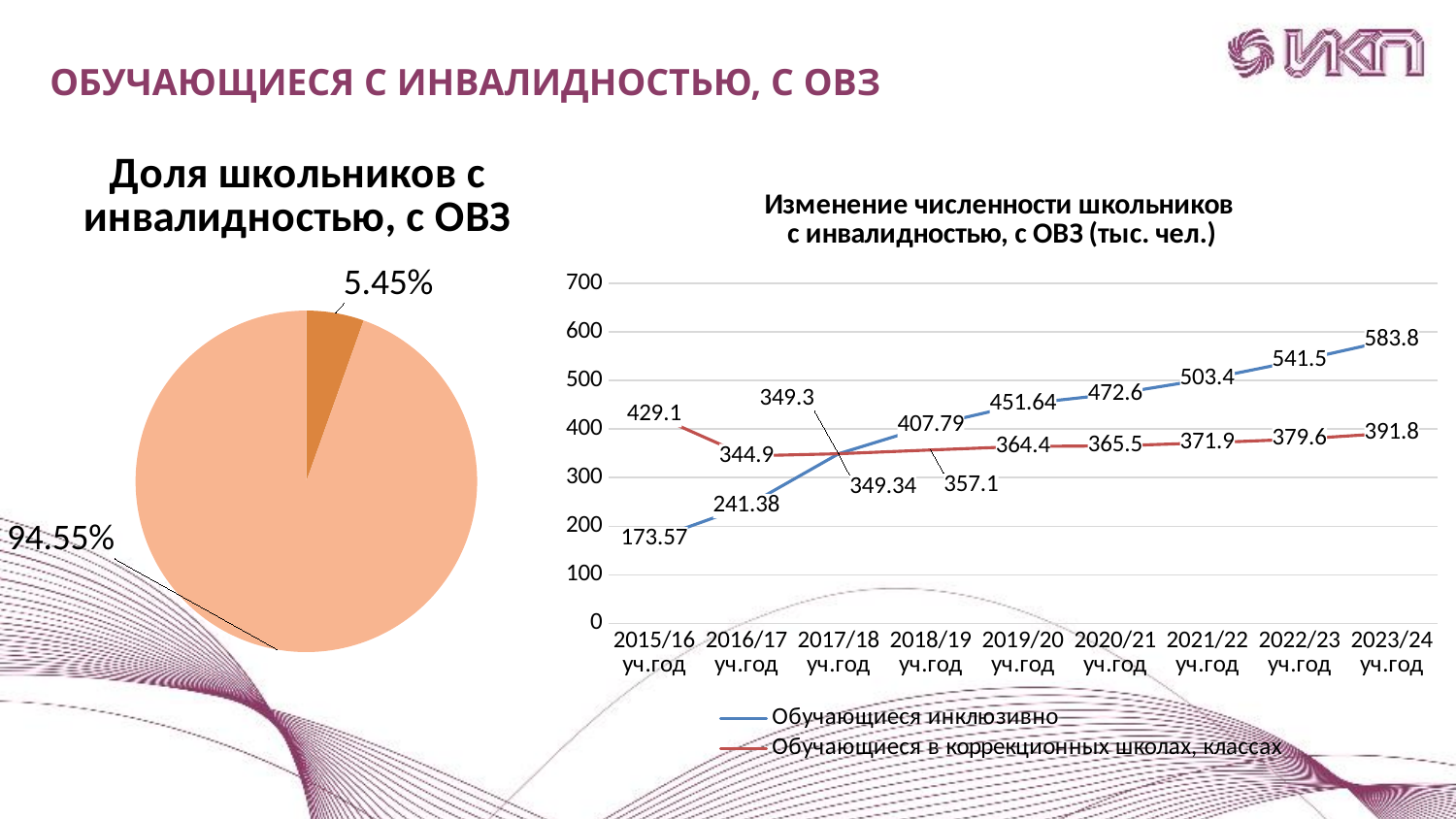
In the line chart "Изменение численности школьников с инвалидностью, с ОВЗ", what is the value for "Обучающиеся инклюзивно" in 2023/24 уч.год? 583.8 In the line chart "Изменение численности школьников с инвалидностью, с ОВЗ", by how much did "Обучающиеся инклюзивно" increase from 2022/23 уч.год to 2023/24 уч.год? 42.3 In the line chart "Изменение численности школьников с инвалидностью, с ОВЗ", which series has the larger value in 2019/20 уч.год? Обучающиеся инклюзивно In the line chart "Изменение численности школьников с инвалидностью, с ОВЗ", does the "Обучающиеся инклюзивно" series rise or fall from 2015/16 to 2023/24? rise In the line chart "Изменение численности школьников с инвалидностью, с ОВЗ", how many series does the legend list? 2 In the line chart "Изменение численности школьников с инвалидностью, с ОВЗ", in which academic year is the value for "Обучающиеся инклюзивно" lowest? 2015/16 уч.год In the line chart "Изменение численности школьников с инвалидностью, с ОВЗ", in which academic year is the value for "Обучающиеся инклюзивно" highest? 2023/24 уч.год In the pie chart "Доля школьников с инвалидностью, с ОВЗ", what share does the larger slice represent? 94.55% In the line chart "Изменение численности школьников с инвалидностью, с ОВЗ", what is the value for "Обучающиеся в коррекционных школах, классах" in 2015/16 уч.год? 429.1 In the line chart "Изменение численности школьников с инвалидностью, с ОВЗ", how many academic years are shown on the x axis? 9 What kind of chart is the chart titled "Доля школьников с инвалидностью, с ОВЗ"? pie chart What kind of chart is the chart titled "Изменение численности школьников с инвалидностью, с ОВЗ (тыс. чел.)"? line chart